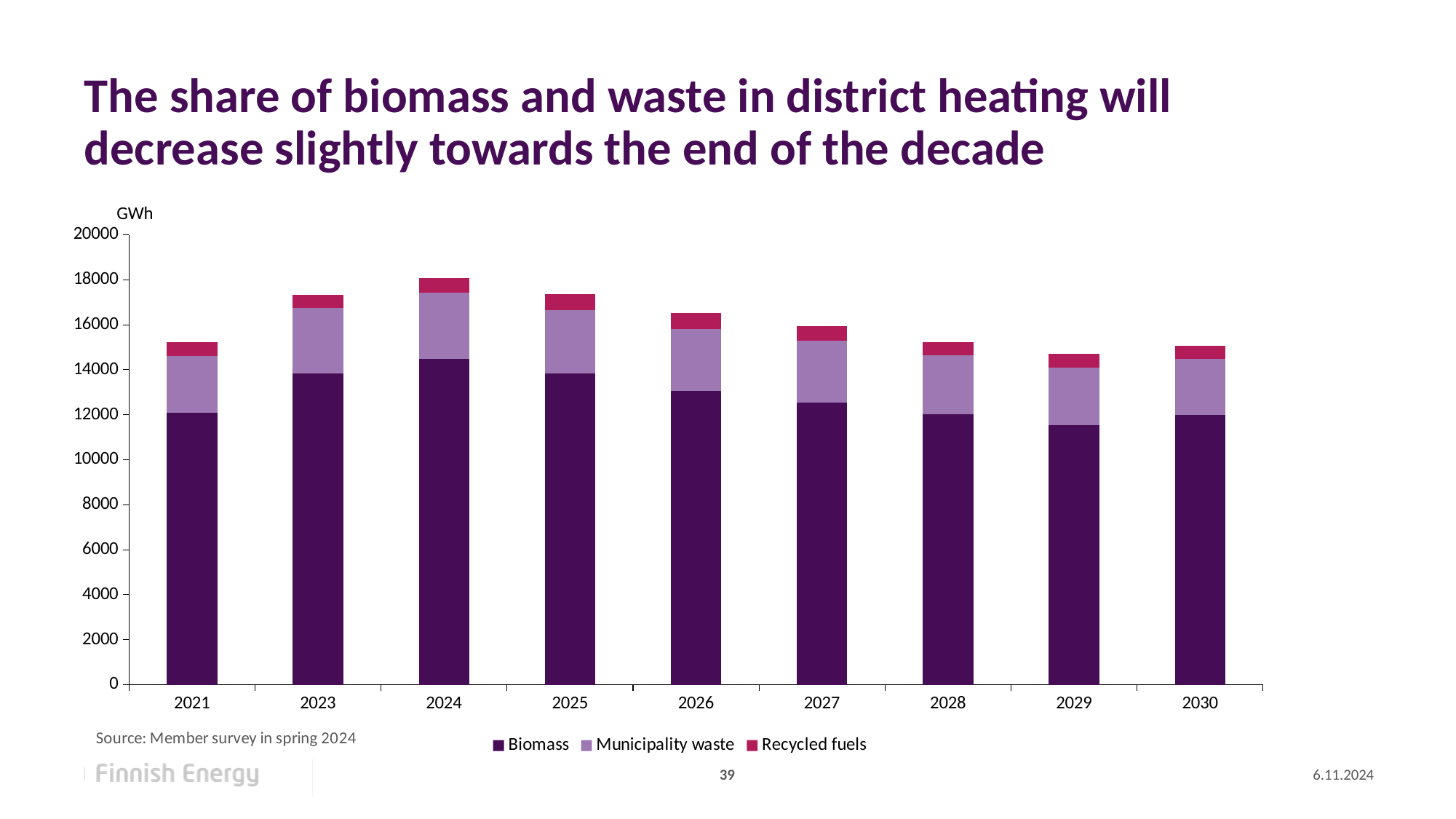
Is the Biomass value for 2026 greater or less than 12000? greater Which is larger, the Biomass value for 2023 or for 2026? 2023 What kind of chart is shown on the slide? Stacked bar chart How many series does the chart's legend list? 3 Which is larger, the total stacked bar for 2024 or for 2029? 2024 How many years are shown on the x axis of the chart? 9 What unit is shown on the y axis of the chart? GWh Is the total stacked value for 2029 greater or less than 16000? less Which year has the highest total stacked bar? 2024 Which year has the highest Biomass value? 2024 Is the total stacked value for 2024 greater or less than 16000? greater Do the total stacked values rise or fall from 2024 to 2029? fall